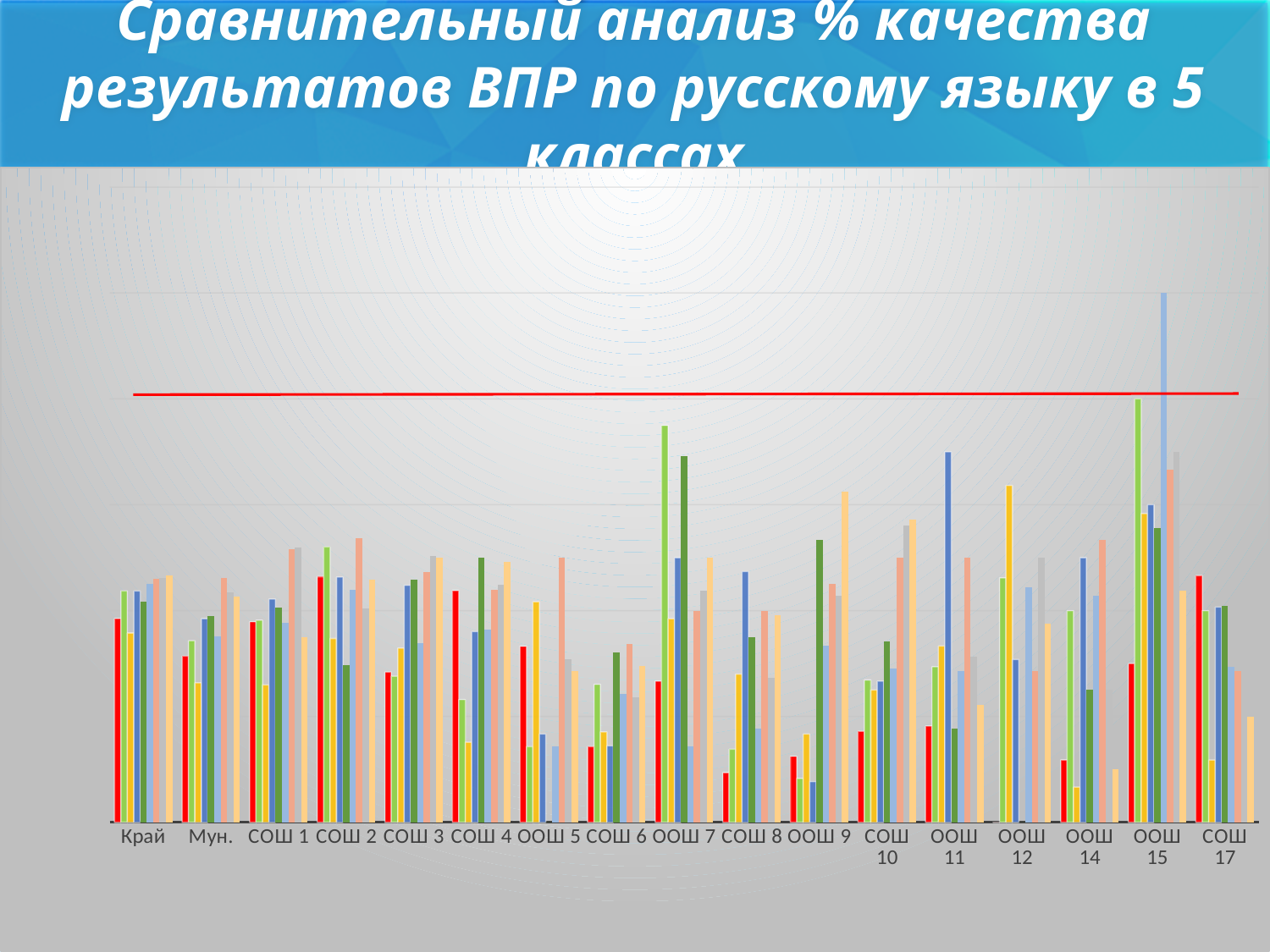
What is the first category on the x axis of the chart? Край What is the last category on the x axis of the chart? СОШ 17 How many categories are shown along the x axis of the chart? 17 What kind of chart is shown on the slide? bar chart Which category contains the tallest bar in the chart? ООШ 15